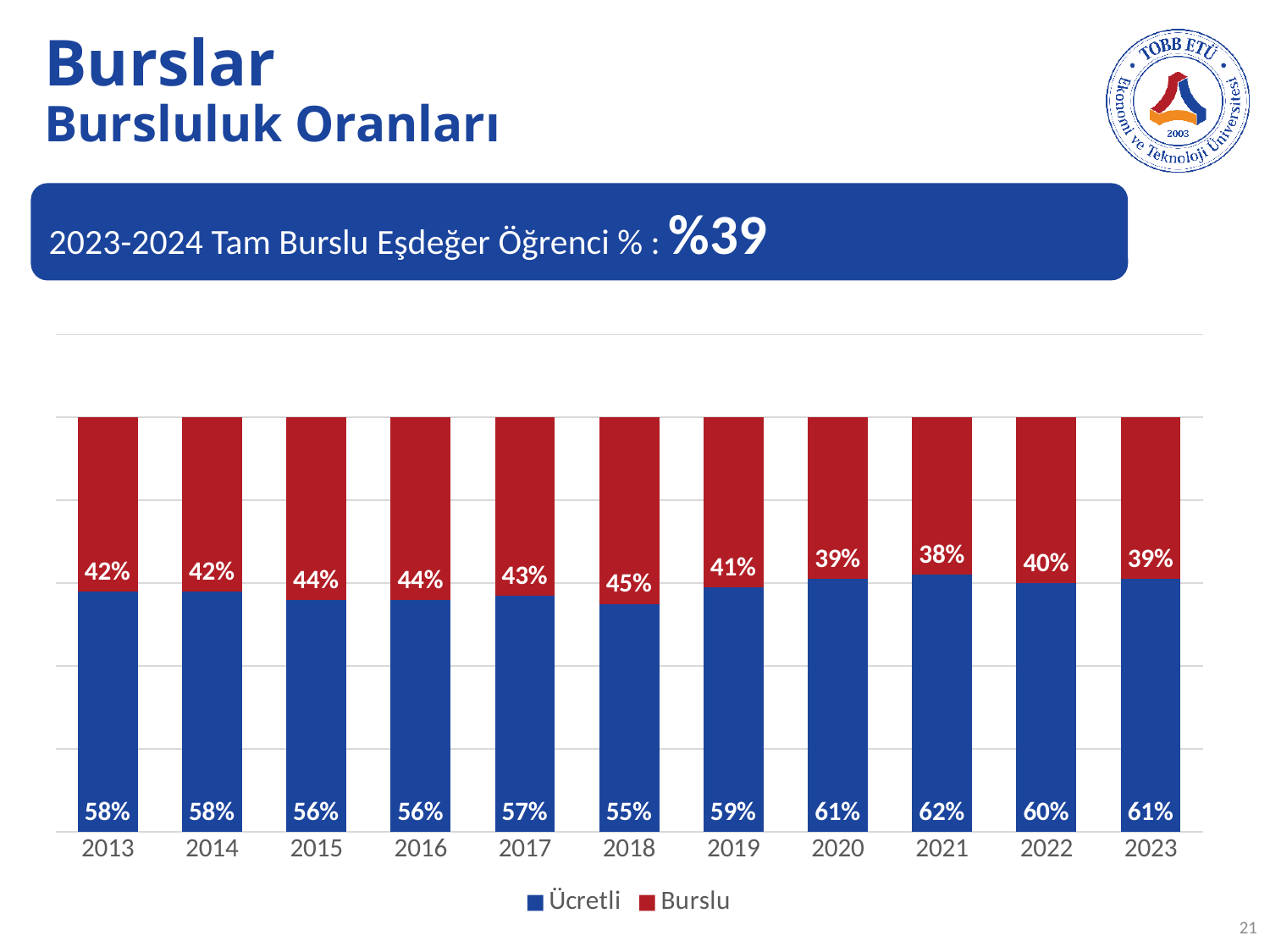
What is the total of the stacked bar for 2019? 100% What is the Burslu value for 2018? 45% What kind of chart is shown on the slide? Stacked bar chart What is the difference between the Ücretli values for 2021 and 2018? 7% What is the Burslu value for 2023? 39% Which is larger, the Burslu value for 2015 or the Burslu value for 2020? 2015 What is the Ücretli value for 2021? 62% Which series is shown in red in the legend? Burslu In which year is the Burslu share highest? 2018 How many series does the legend list? 2 In which year is the Burslu share lowest? 2021 How many years are shown on the x axis of the chart? 11